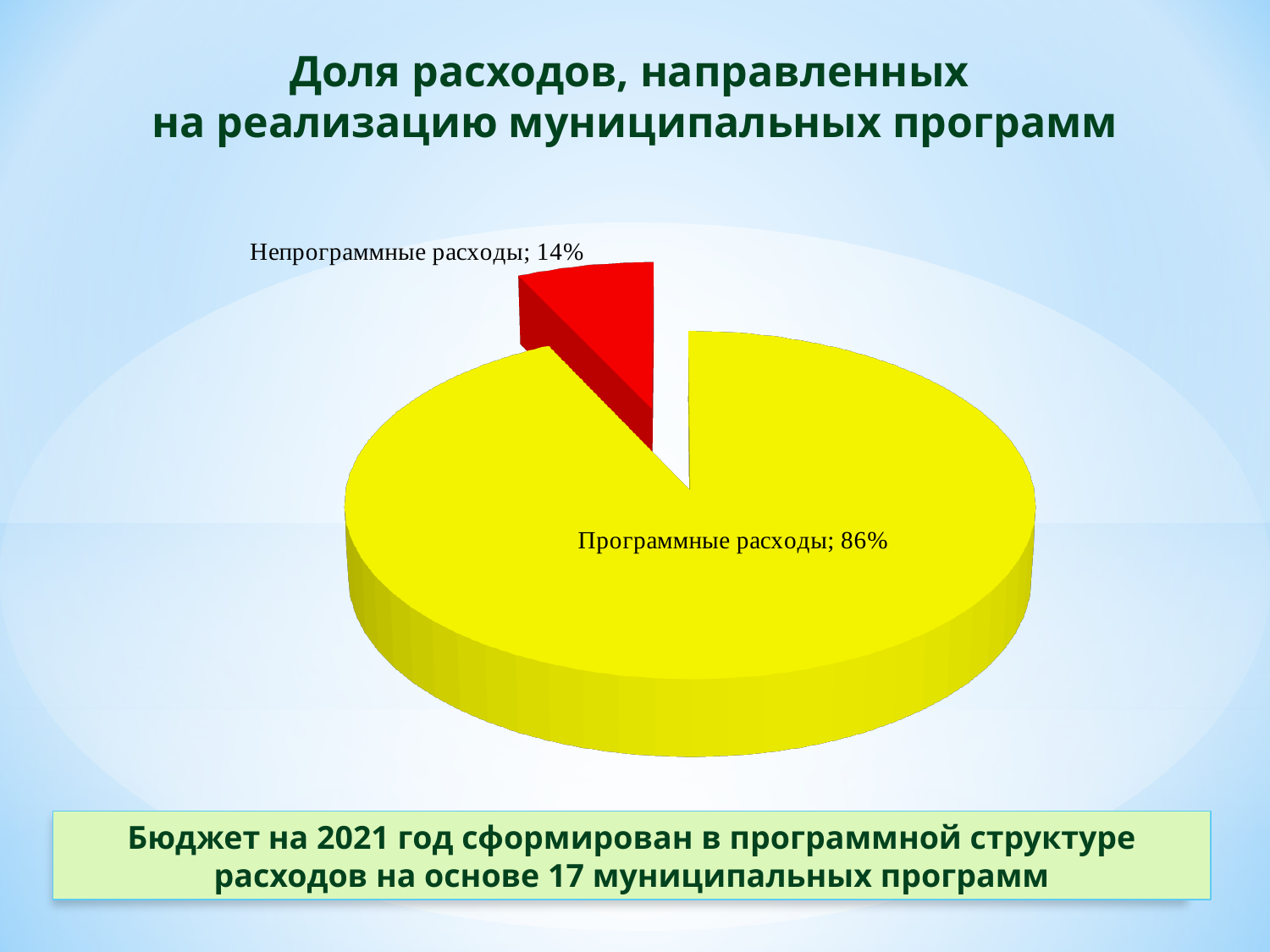
What share of the pie is labelled "Программные расходы"? 86% How many slices does the pie chart have? 2 What colour is the slice for "Программные расходы"? Yellow Which slice of the pie is the largest? Программные расходы What is the total of the two slices shown in the pie chart? 100% What kind of chart is shown on the slide? Pie chart What colour is the slice for "Непрограммные расходы"? Red What share of the pie is labelled "Непрограммные расходы"? 14% Which is larger: "Программные расходы" or "Непрограммные расходы"? Программные расходы Is the share for "Программные расходы" greater or less than 50%? greater What is the difference in percentage points between "Программные расходы" and "Непрограммные расходы"? 72 Which slice of the pie is the smallest? Непрограммные расходы